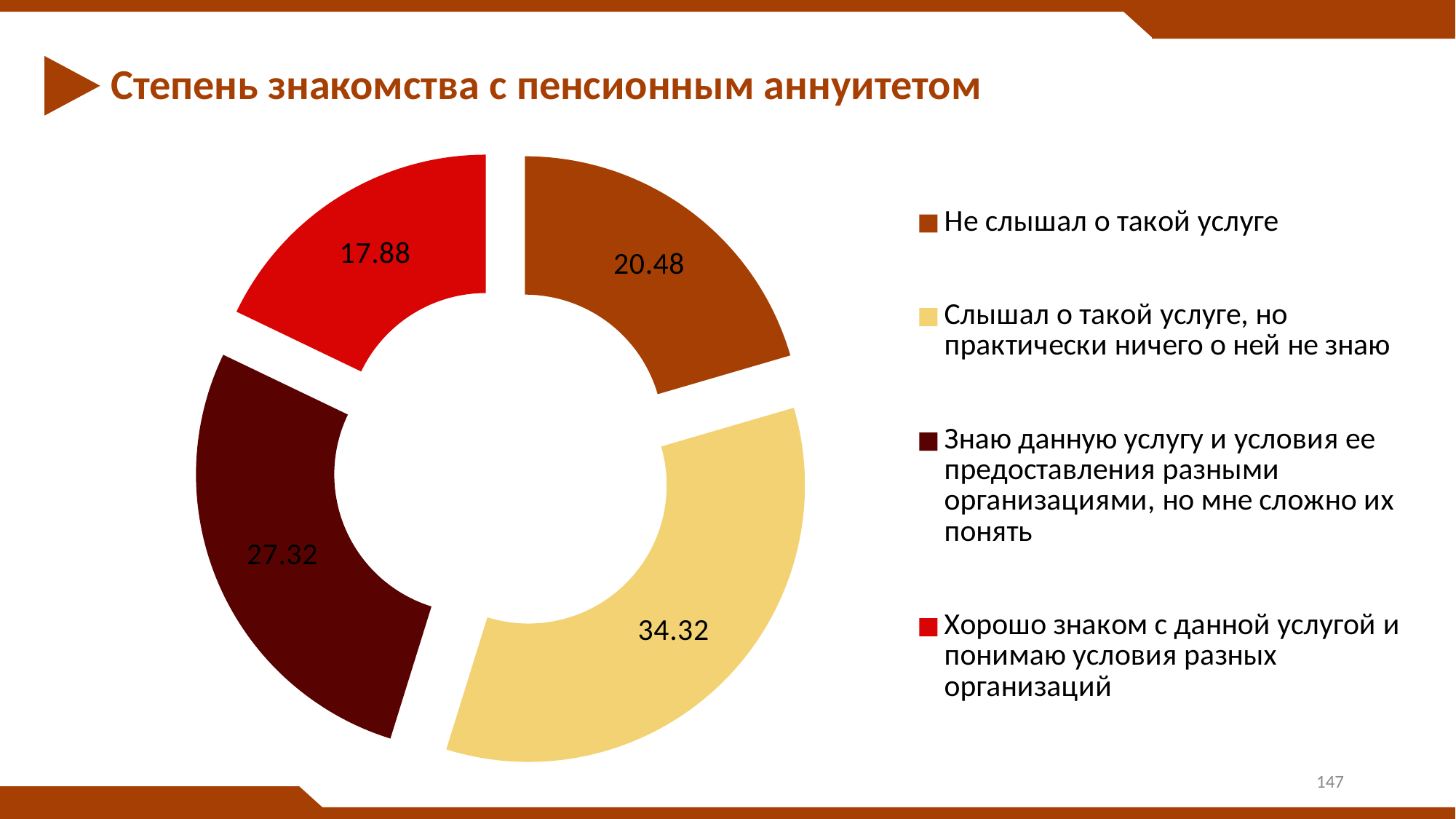
What is the title of the slide? Степень знакомства с пенсионным аннуитетом What value is shown for the slice "Хорошо знаком с данной услугой и понимаю условия разных организаций"? 17.88 How many slices does the chart have? 4 Which category has the smallest slice in the chart? Хорошо знаком с данной услугой и понимаю условия разных организаций Which is larger: the value for "Не слышал о такой услуге" or the value for "Хорошо знаком с данной услугой и понимаю условия разных организаций"? Не слышал о такой услуге What type of chart is shown on the slide? Doughnut (pie) chart Which category has the largest slice in the chart? Слышал о такой услуге, но практически ничего о ней не знаю What colour is the slice for "Хорошо знаком с данной услугой и понимаю условия разных организаций"? Red What value is shown for the slice "Слышал о такой услуге, но практически ничего о ней не знаю"? 34.32 What value is shown for the slice "Не слышал о такой услуге"? 20.48 What is the difference between the values for "Слышал о такой услуге, но практически ничего о ней не знаю" and "Не слышал о такой услуге"? 13.84 What value is shown for the slice "Знаю данную услугу и условия ее предоставления разными организациями, но мне сложно их понять"? 27.32